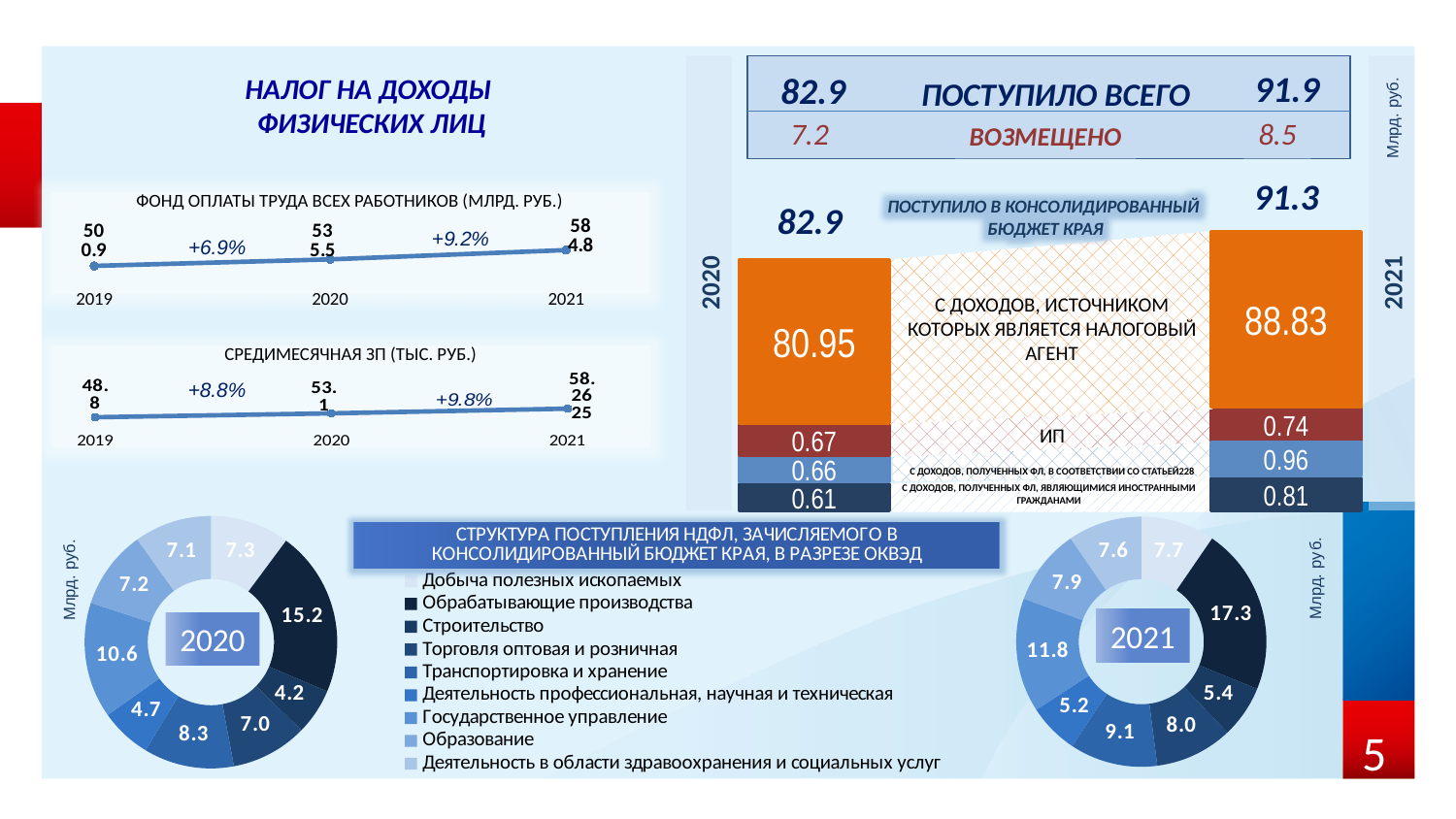
In the stacked bar chart for 2021, what is the value for income whose source is a tax agent (налоговый агент)? 88.83 In the 2020 donut chart, what is the smallest slice value? 4.2 In the stacked bar chart, what is the value for ИП in 2021? 0.74 In the chart 'ФОНД ОПЛАТЫ ТРУДА ВСЕХ РАБОТНИКОВ', what growth percentage is shown between 2020 and 2021? +9.2% In the stacked bar chart for 2020, what is the value for income whose source is a tax agent (налоговый агент)? 80.95 How many categories does the legend of the donut charts (структура поступления НДФЛ в разрезе ОКВЭД) list? 9 In the 2021 donut chart (структура поступления НДФЛ в разрезе ОКВЭД), what is the largest slice value? 17.3 In the stacked bar chart, what is the total shown above the 2021 bar (поступило в консолидированный бюджет края)? 91.3 In the 2020 donut chart (структура поступления НДФЛ в разрезе ОКВЭД), what is the largest slice value? 15.2 In the stacked bar chart, what is the total shown above the 2020 bar (поступило в консолидированный бюджет края)? 82.9 In the stacked bar chart for 2021, which is larger: the ИП segment or the segment for income under статья 228? статья 228 (0.96) In the stacked bar chart, by how much did the tax-agent segment grow from 2020 (80.95) to 2021 (88.83)? 7.88